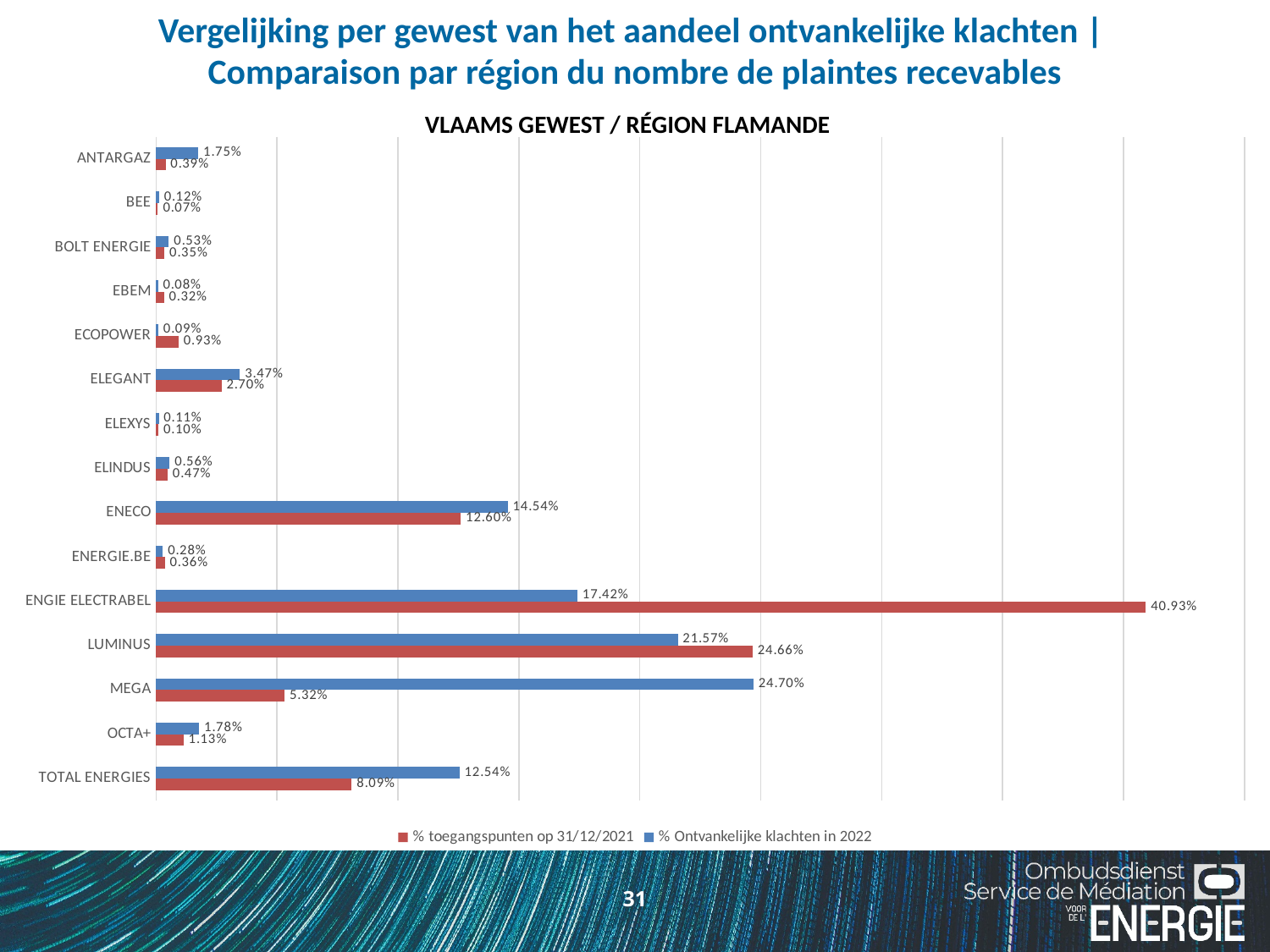
How many series does the legend list? 2 How many suppliers (categories) are shown on the chart? 15 What is the value of '% Ontvankelijke klachten in 2022' for ENECO? 14.54% What type of chart is shown on the slide? bar chart Which supplier has the highest '% toegangspunten op 31/12/2021'? ENGIE ELECTRABEL What is the difference between the '% toegangspunten op 31/12/2021' and '% Ontvankelijke klachten in 2022' values for ENGIE ELECTRABEL? 23.51 percentage points Which supplier has the highest '% Ontvankelijke klachten in 2022'? MEGA What is the value of '% Ontvankelijke klachten in 2022' for MEGA? 24.70% What is the value of '% toegangspunten op 31/12/2021' for ENGIE ELECTRABEL? 40.93% What is the subtitle shown above the chart? VLAAMS GEWEST / RÉGION FLAMANDE For TOTAL ENERGIES, which is larger: '% toegangspunten op 31/12/2021' or '% Ontvankelijke klachten in 2022'? % Ontvankelijke klachten in 2022 For LUMINUS, which is larger: '% toegangspunten op 31/12/2021' or '% Ontvankelijke klachten in 2022'? % toegangspunten op 31/12/2021